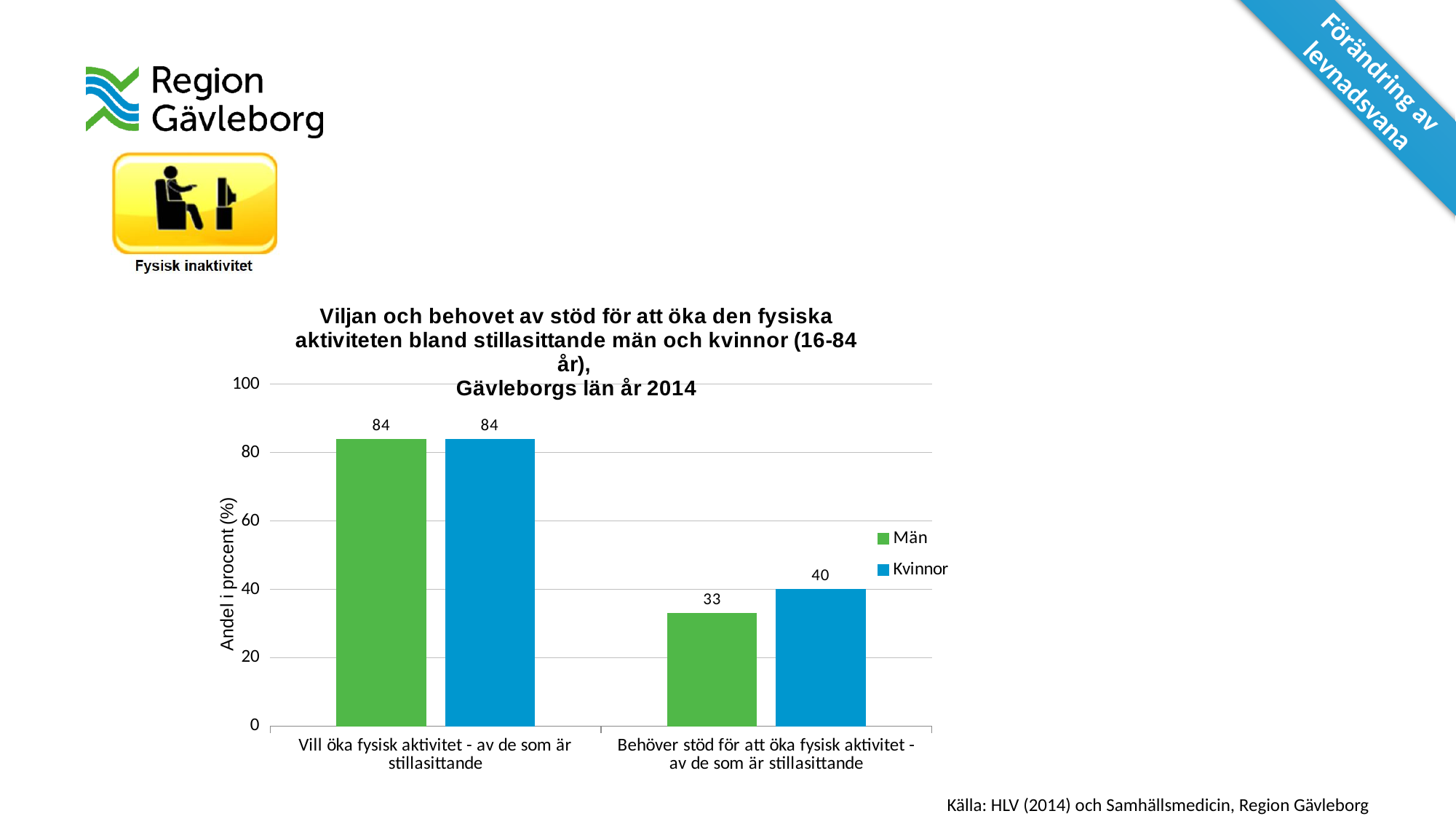
What is the value for Kvinnor in the category "Vill öka fysisk aktivitet - av de som är stillasittande"? 84 How many categories are shown on the x axis? 2 What is the value for Kvinnor in the category "Behöver stöd för att öka fysisk aktivitet - av de som är stillasittande"? 40 In the category "Behöver stöd för att öka fysisk aktivitet - av de som är stillasittande", which series has the larger value, Män or Kvinnor? Kvinnor How many series does the legend list? 2 Which category has the highest value for Kvinnor? Vill öka fysisk aktivitet - av de som är stillasittande What is the label of the y axis? Andel i procent (%) Which category has the lowest value for Män? Behöver stöd för att öka fysisk aktivitet - av de som är stillasittande What kind of chart is shown on the slide? Bar chart What is the difference between the Kvinnor and Män values in the category "Behöver stöd för att öka fysisk aktivitet - av de som är stillasittande"? 7 What is the value for Män in the category "Behöver stöd för att öka fysisk aktivitet - av de som är stillasittande"? 33 What is the value for Män in the category "Vill öka fysisk aktivitet - av de som är stillasittande"? 84